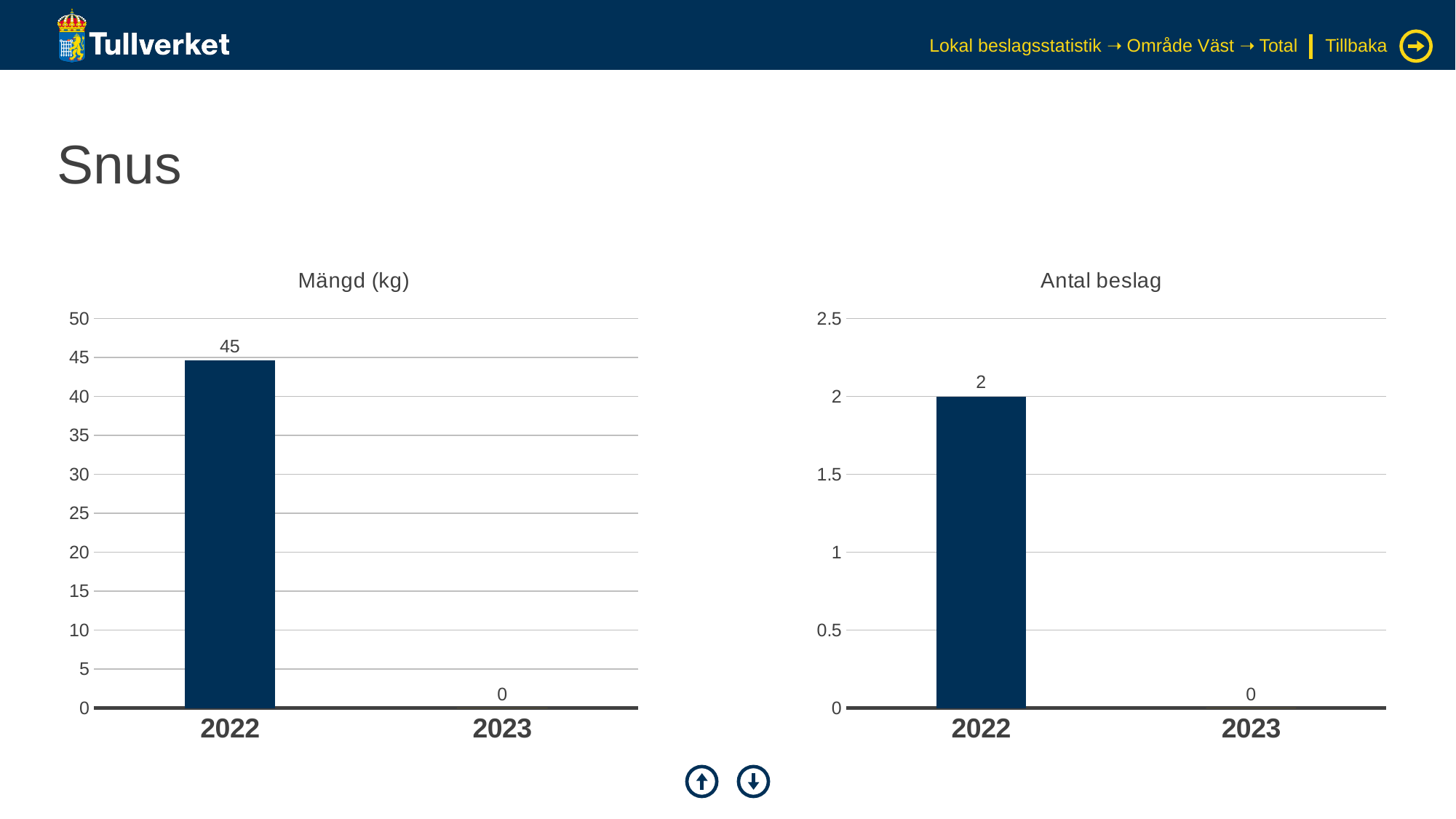
In the 'Antal beslag' chart, which year has the lowest value? 2023 In the 'Antal beslag' chart, what is the value for 2022? 2 In the 'Mängd (kg)' chart, what is the difference between the values for 2022 and 2023? 45 In the 'Mängd (kg)' chart, which year has the highest value? 2022 In the 'Mängd (kg)' chart, what is the value for 2022? 45 In the 'Mängd (kg)' chart, is the value for 2022 greater or less than 40? greater How many years are shown on the x axis of the 'Antal beslag' chart? 2 In the 'Antal beslag' chart, do the values rise or fall from 2022 to 2023? fall What kind of chart is the 'Mängd (kg)' chart? bar chart In the 'Antal beslag' chart, what is the value for 2023? 0 In the 'Antal beslag' chart, what is the difference between the values for 2022 and 2023? 2 In the 'Mängd (kg)' chart, what is the value for 2023? 0